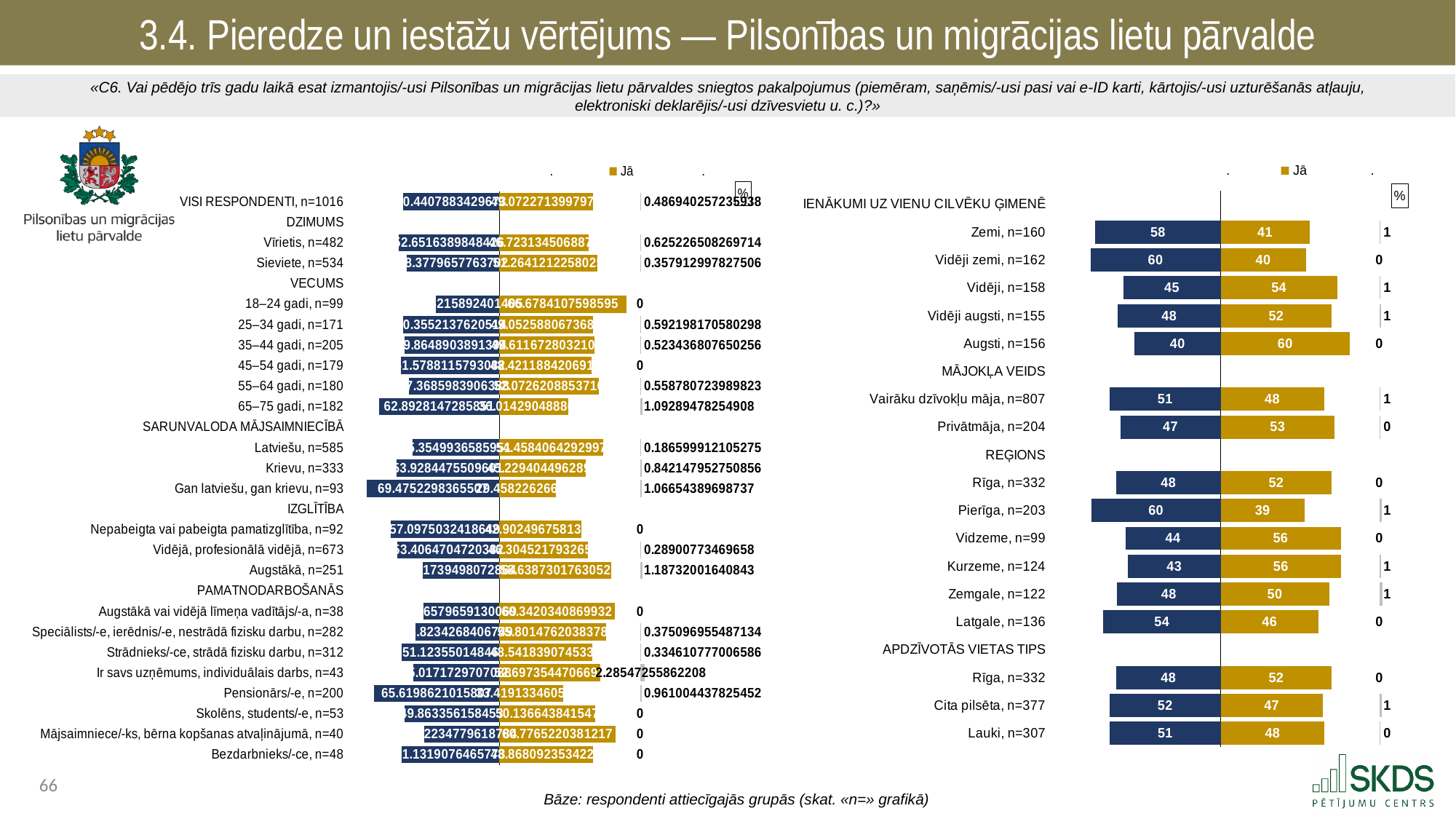
In the right-hand chart, what is the dark blue value for Pierīga, n=203? 60 In the right-hand chart, how many income groups are listed under IENĀKUMI UZ VIENU CILVĒKU ĢIMENĒ? 5 In the right-hand chart, how many regions are listed under REĢIONS? 6 In the right-hand chart, which has the larger 'Jā' value: Privātmāja, n=204 or Vairāku dzīvokļu māja, n=807? Privātmāja, n=204 In the left-hand chart, how many age groups are listed under VECUMS? 6 In the right-hand chart, what is the total of the stacked bar for Zemi, n=160? 100 In the right-hand chart, what is the difference between the 'Jā' values for Vidzeme, n=99 and Latgale, n=136? 10 In the right-hand chart, which region under REĢIONS has the lowest 'Jā' value? Pierīga, n=203 What kind of chart is the right-hand chart? Stacked bar chart In the right-hand chart, what is the 'Jā' value for Kurzeme, n=124? 56 In the right-hand chart, which income group under IENĀKUMI UZ VIENU CILVĒKU ĢIMENĒ has the highest 'Jā' value? Augsti, n=156 In the right-hand chart, what is the 'Jā' value for Augsti, n=156? 60